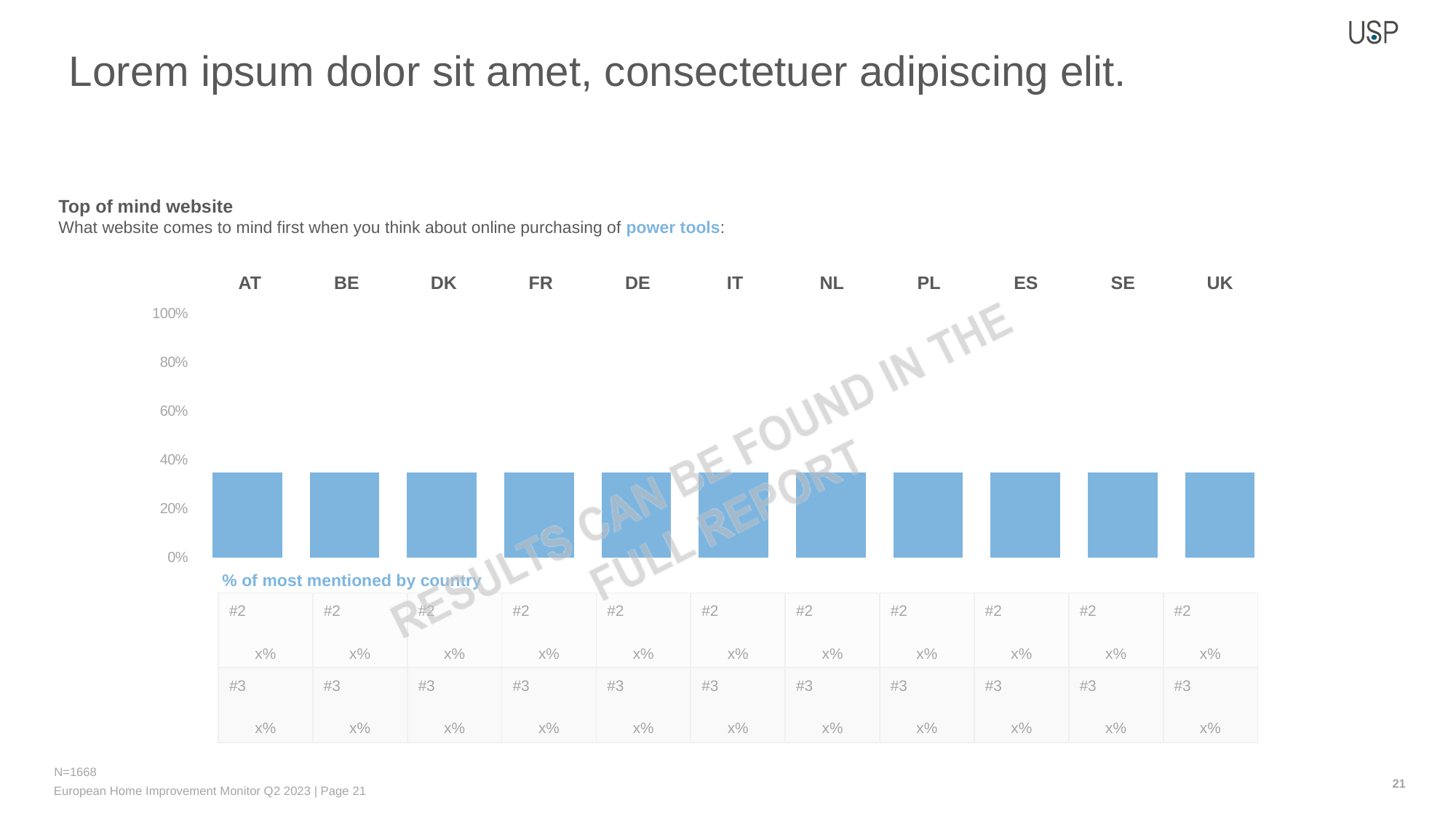
Is the value for DE greater or less than 40%? less Do the bar values rise, fall, or stay roughly flat from AT to UK? stay roughly flat Is the value for UK greater or less than 60%? less What is the highest value shown on the chart's y axis? 100% How many countries are shown along the x axis of the chart? 11 Is the value for AT greater or less than 20%? greater Which country label appears first (leftmost) on the chart? AT What is the bold heading above the chart's question text? Top of mind website Which country label appears last (rightmost) on the chart? UK What kind of chart is shown on the slide? bar chart